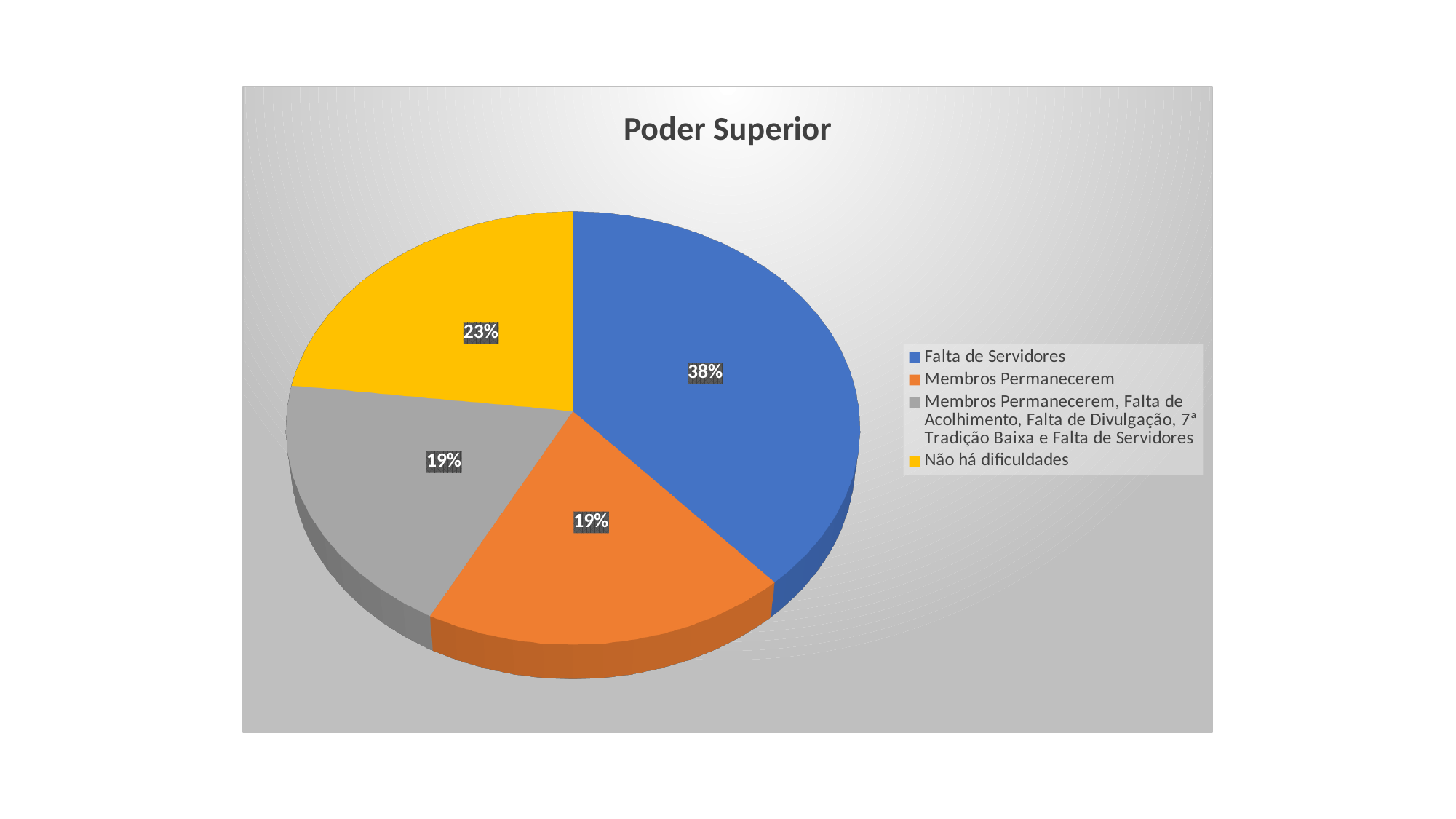
Which category has the largest slice of the pie? Falta de Servidores What share of the pie does "Falta de Servidores" represent? 38% How many slices does the pie chart have? 4 What kind of chart is shown on the slide? pie chart How many entries does the legend list? 4 What is the difference between the share for "Falta de Servidores" and the share for "Membros Permanecerem"? 19% What is the title of the chart? Poder Superior What share of the pie does "Membros Permanecerem" represent? 19% What share of the pie does "Não há dificuldades" represent? 23% Which is larger, the share for "Não há dificuldades" or the share for "Membros Permanecerem"? Não há dificuldades What colour is the slice for "Não há dificuldades"? yellow What is the difference between the share for "Falta de Servidores" and the share for "Não há dificuldades"? 15%